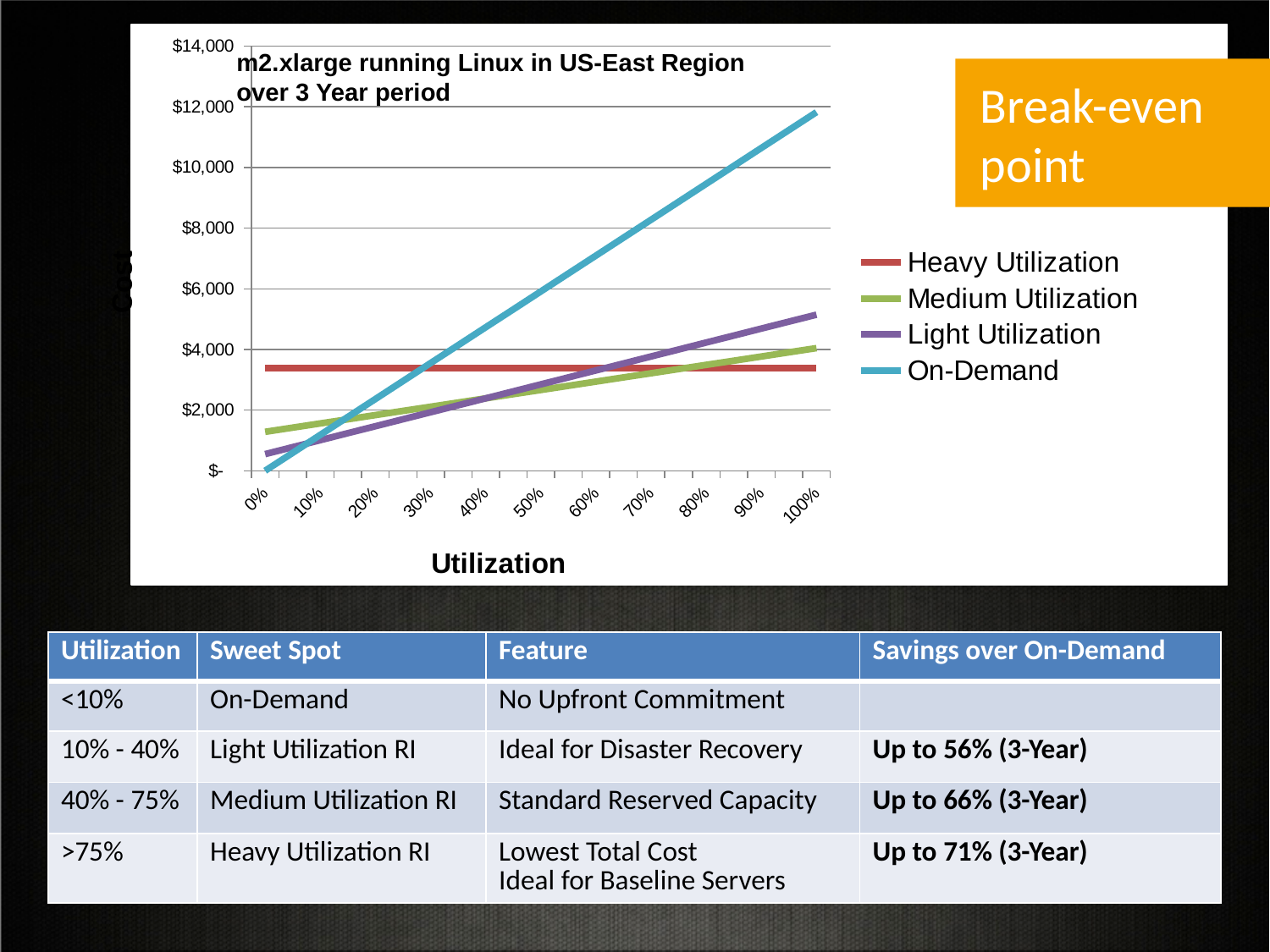
Is the Light Utilization cost at 100% utilization greater or less than $4,000? greater What is the label of the chart's x axis? Utilization Is the Heavy Utilization cost greater or less than $4,000? less Does the Heavy Utilization line rise, fall, or stay flat as utilization increases? stay flat Is the On-Demand cost at 100% utilization greater or less than $10,000? greater What kind of chart is shown on the slide? line chart At 0% utilization, which is larger: the Medium Utilization cost or the On-Demand cost? Medium Utilization How many series does the chart legend list? 4 Does the On-Demand line rise or fall as utilization increases? rise What is the title of the chart? m2.xlarge running Linux in US-East Region over 3 Year period Which series has the highest cost at 100% utilization? On-Demand